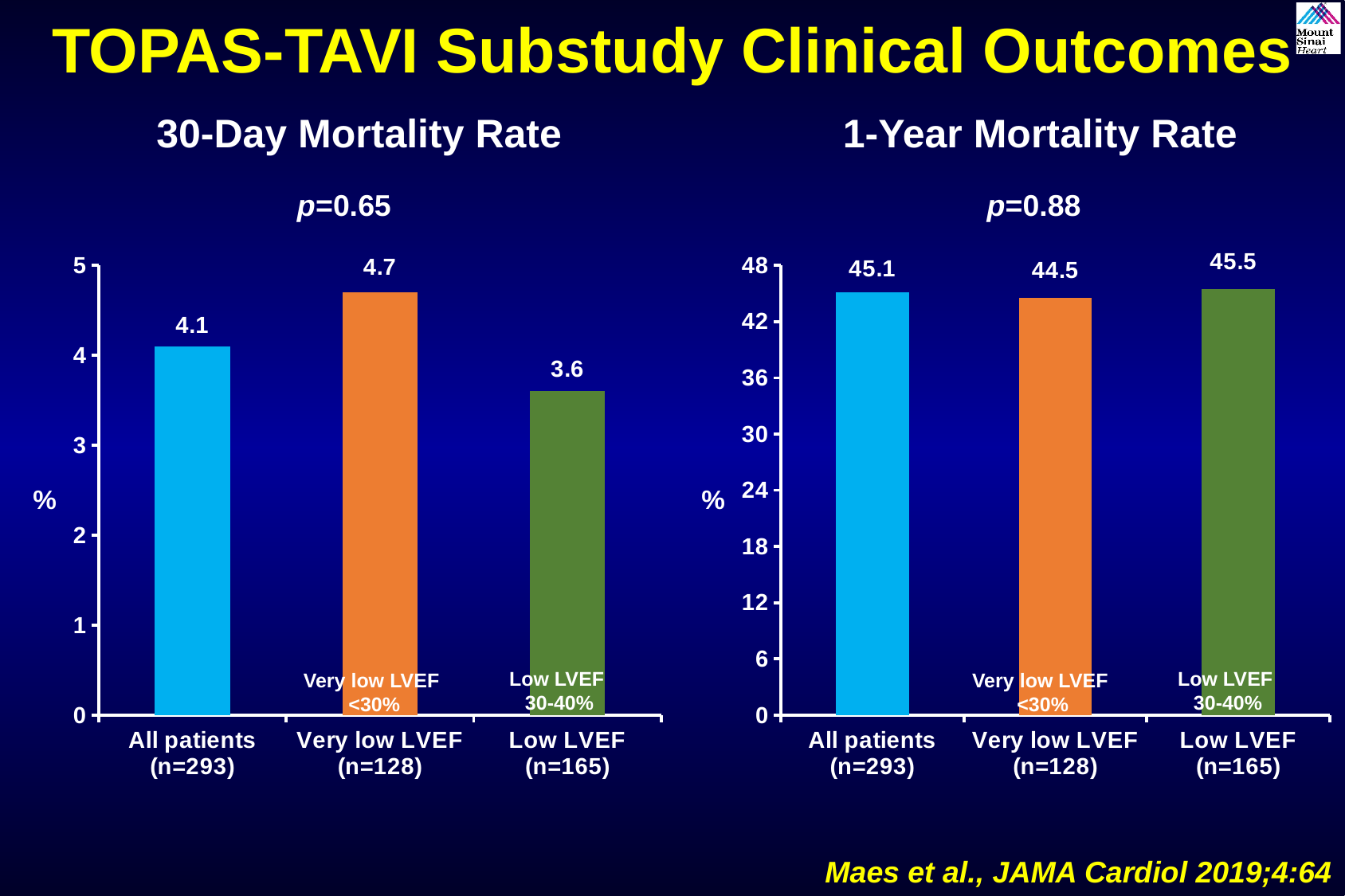
In the 30-Day Mortality Rate chart, what is the value for All patients (n=293)? 4.1 How many categories are shown in the 1-Year Mortality Rate chart? 3 In the 30-Day Mortality Rate chart, which category has the lowest value? Low LVEF (n=165) What type of chart is the 30-Day Mortality Rate chart? Bar chart In the 1-Year Mortality Rate chart, what is the difference between the values for Low LVEF and Very low LVEF? 1.0 In the 30-Day Mortality Rate chart, is the value for Low LVEF (n=165) greater or less than 4? less In the 30-Day Mortality Rate chart, what is the difference between the values for Very low LVEF and Low LVEF? 1.1 In the 30-Day Mortality Rate chart, which category has the highest value? Very low LVEF (n=128) In the 30-Day Mortality Rate chart, what is the value for Very low LVEF (n=128)? 4.7 In the 1-Year Mortality Rate chart, which category has the lowest value? Very low LVEF (n=128) In the 1-Year Mortality Rate chart, what is the value for All patients (n=293)? 45.1 In the 1-Year Mortality Rate chart, what is the value for Low LVEF (n=165)? 45.5